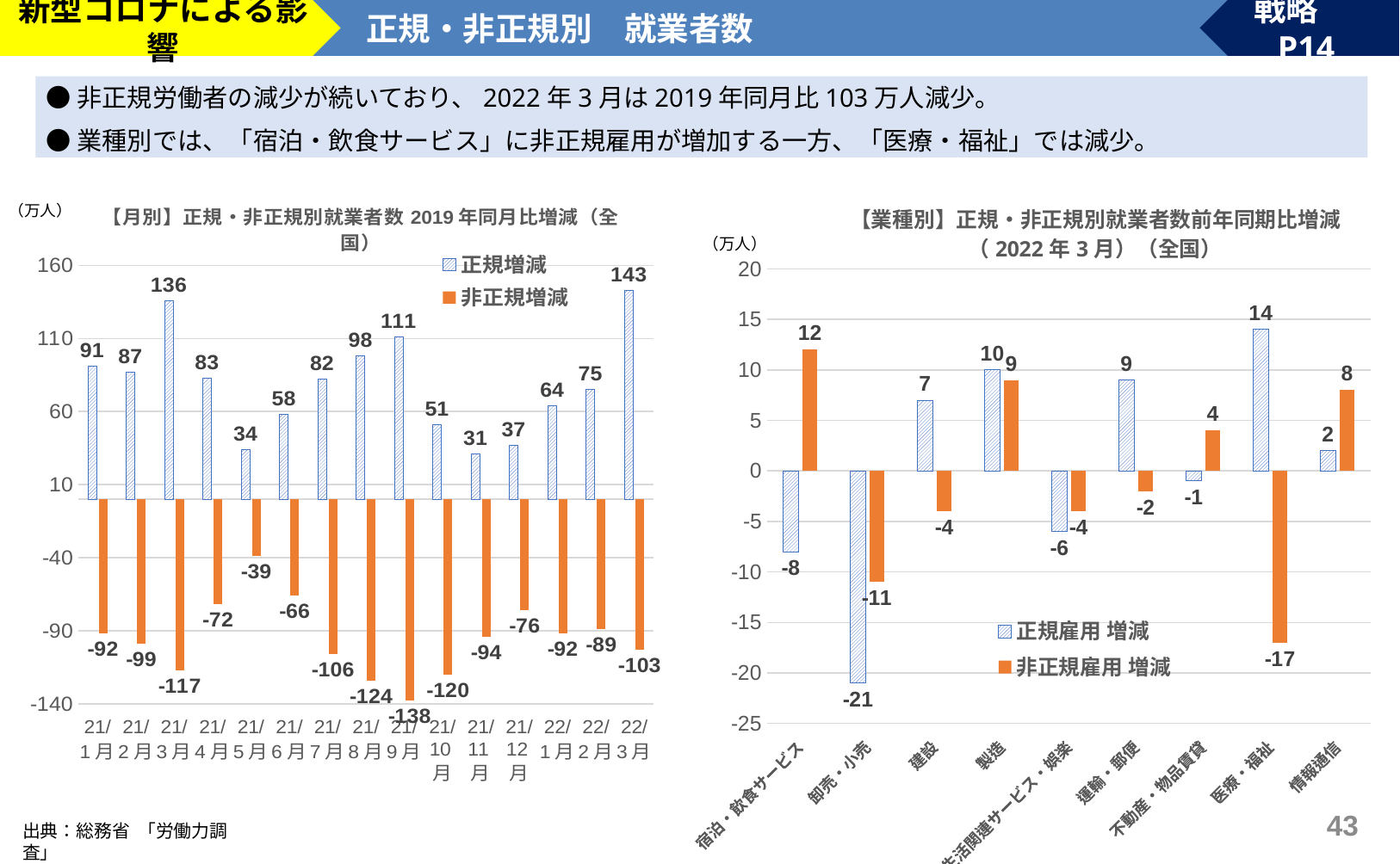
In the left chart (【月別】), what is the value of 非正規増減 for 21/9月? -138 In the left chart (【月別】), which month has the highest 正規増減 value? 22/3月 In the left chart (【月別】), what is the difference between the 正規増減 values for 21/3月 and 21/5月? 102 In the right chart (【業種別】), what is the 非正規雇用 増減 value for 医療・福祉? -17 In the left chart (【月別】正規・非正規別就業者数 2019年同月比増減), what is the value of 正規増減 for 22/3月? 143 In the left chart (【月別】), is the 正規増減 value for 21/8月 larger than the value for 21/10月? Yes, 21/8月 (98) In the right chart (【業種別】), how many series does the legend list? 2 In the right chart (【業種別】), which industry has the highest 非正規雇用 増減 value? 宿泊・飲食サービス In the left chart (【月別】), how many months are shown on the x axis? 15 In the left chart (【月別】), which month has the lowest 非正規増減 value? 21/9月 What type of chart is the right chart (【業種別】)? Bar chart In the right chart (【業種別】), which industry has the lowest 正規雇用 増減 value? 卸売・小売